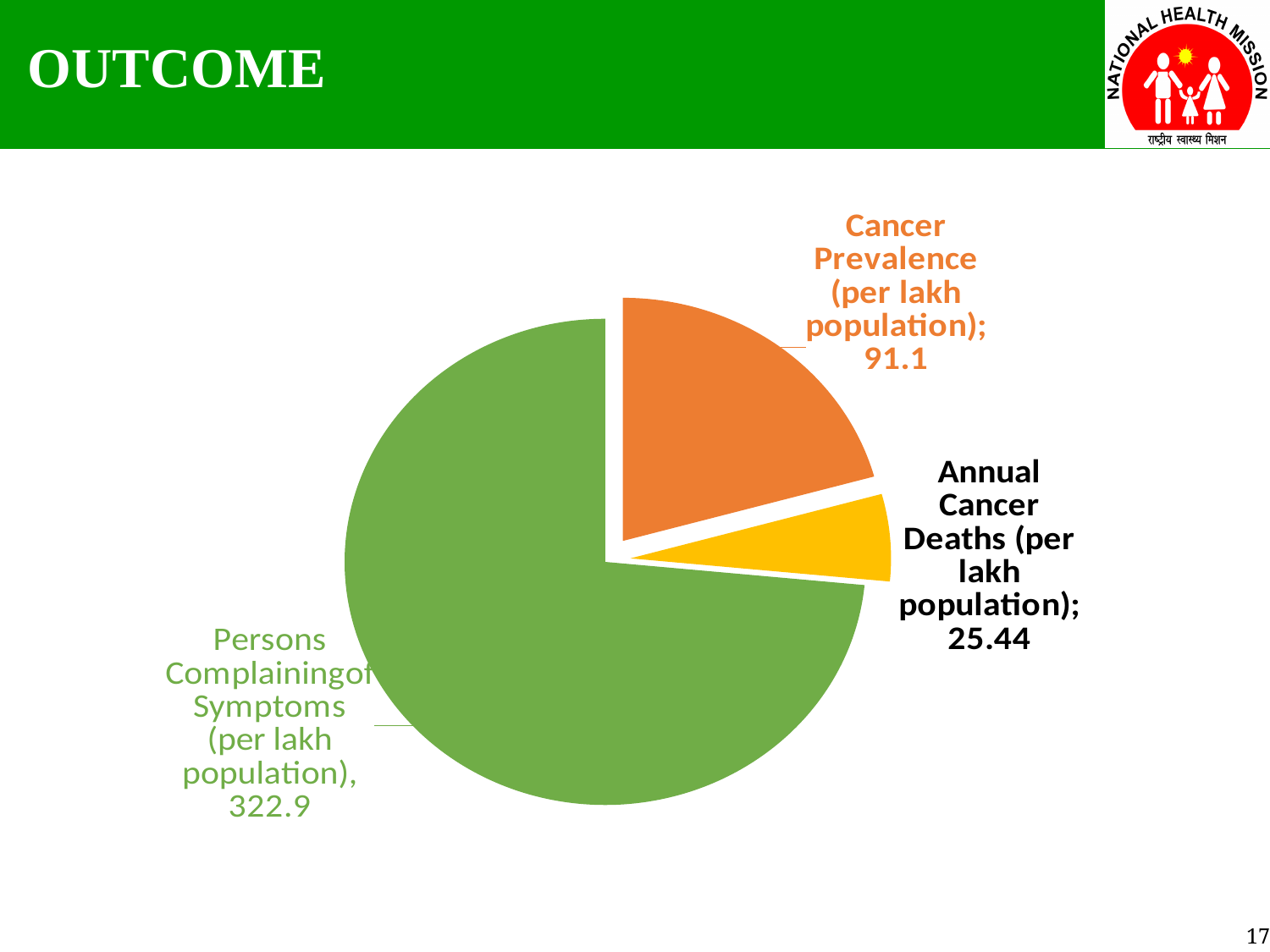
What is the difference between the value for Persons Complaining of Symptoms and the value for Cancer Prevalence? 231.8 Which category has the largest slice of the pie? Persons Complaining of Symptoms (per lakh population) Which is larger, the value for Cancer Prevalence or the value for Annual Cancer Deaths? Cancer Prevalence How many slices does the pie chart have? 3 What colour is the slice for Cancer Prevalence (per lakh population)? orange What is the total of all three values shown in the pie chart? 439.44 What is the value for Cancer Prevalence (per lakh population)? 91.1 What is the value for Persons Complaining of Symptoms (per lakh population)? 322.9 Which category has the smallest slice of the pie? Annual Cancer Deaths (per lakh population) What kind of chart is shown on the slide? pie chart What is the difference between the value for Cancer Prevalence and the value for Annual Cancer Deaths? 65.66 What is the value for Annual Cancer Deaths (per lakh population)? 25.44